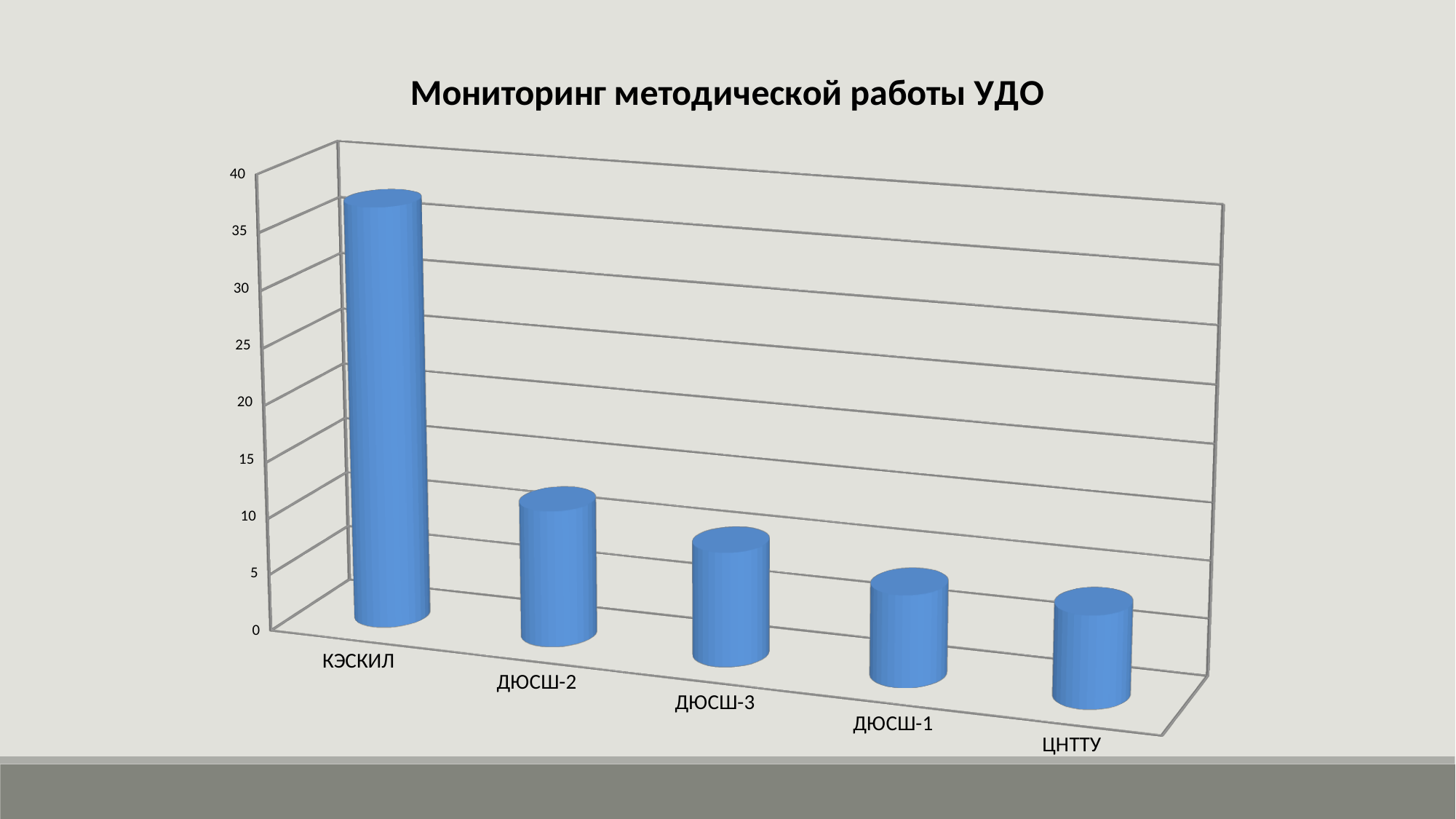
Is the value for ЦНТТУ greater or less than 10? less Is the value for ДЮСШ-2 greater or less than 5? greater Which category has the highest value in the chart? КЭСКИЛ What is the title of the chart? Мониторинг методической работы УДО Is the value for ДЮСШ-1 greater or less than 10? less What kind of chart is shown on the slide? bar chart Which has the larger value, ДЮСШ-2 or ДЮСШ-3? ДЮСШ-2 How many categories are shown on the x axis of the chart? 5 Do the values rise or fall from left to right along the x axis? fall